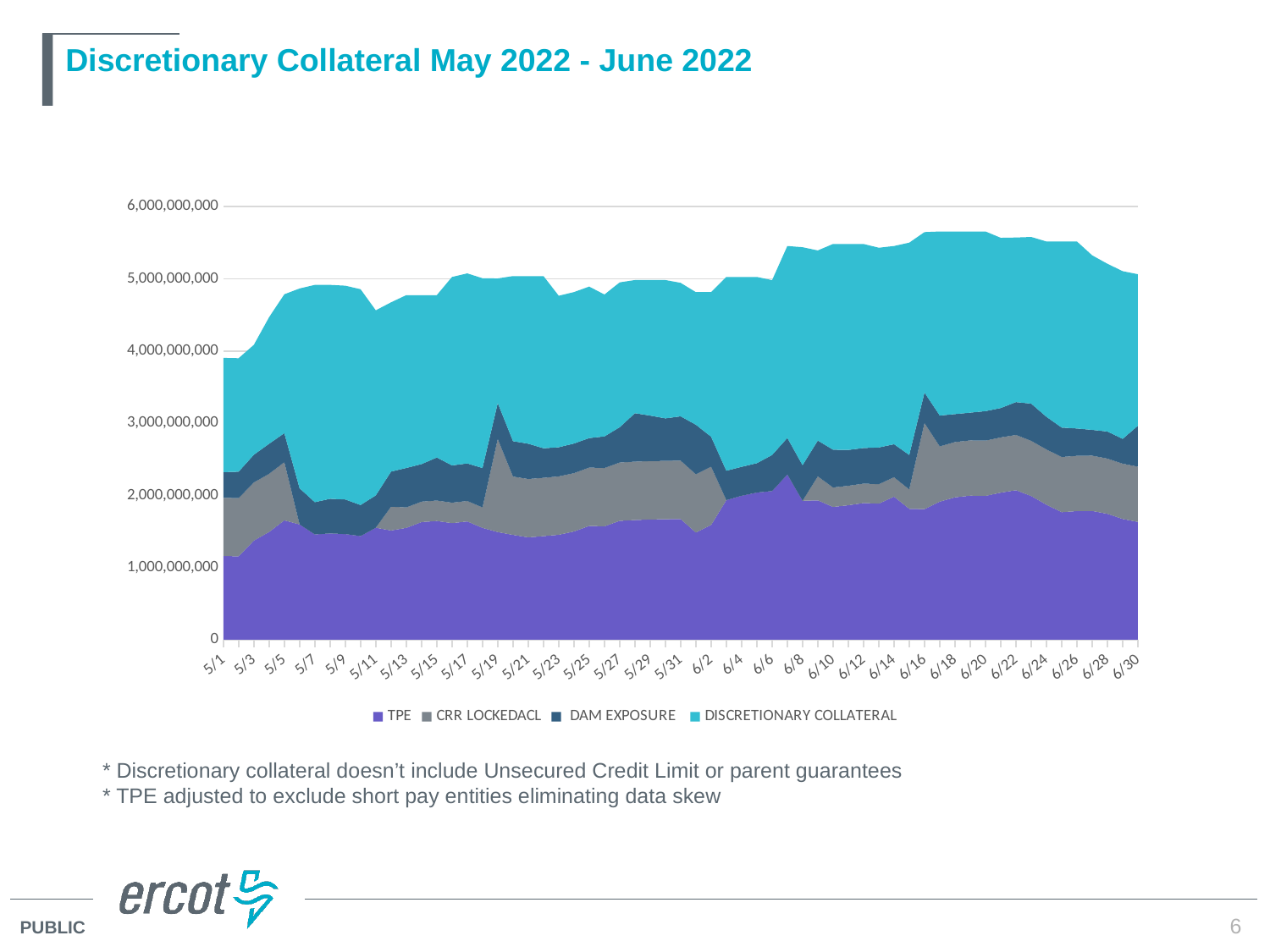
What is the highest value shown on the y axis? 6,000,000,000 Is the total height of the stacked areas on 6/30 greater or less than 4,000,000,000? greater What is the last date label on the x axis? 6/30 What is the title of the chart? Discretionary Collateral May 2022 - June 2022 Is the total height of the stacked areas higher at the end of June than at the start of May? Yes, higher What is the first date label on the x axis? 5/1 Is the TPE value on 5/1 greater or less than 2,000,000,000? less Which series is shown in purple at the bottom of the stack? TPE Is the total height of the stacked areas on 5/1 greater or less than 3,000,000,000? greater What kind of chart is shown on the slide? Stacked area chart How many series does the legend list? 4